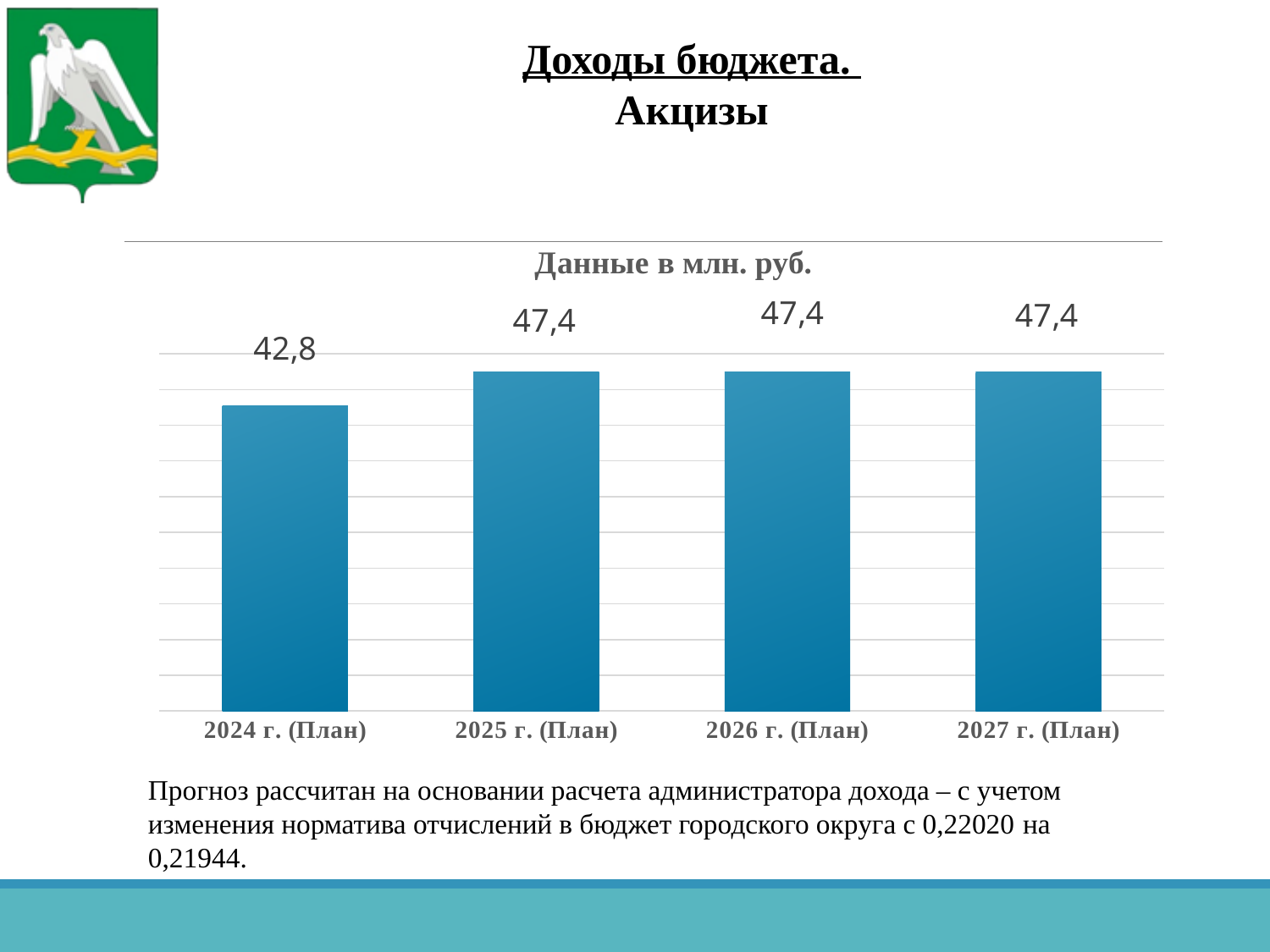
Do the values change from 2025 г. (План) to 2027 г. (План)? No, they stay at 47,4 What is the difference between the values for 2025 г. (План) and 2024 г. (План)? 4,6 Do the values rise or fall from 2024 г. (План) to 2025 г. (План)? Rise How many categories are shown on the chart? 4 What is the value for 2027 г. (План)? 47,4 Which category has the lowest value? 2024 г. (План) What colour are the bars in the chart? Blue What kind of chart is shown on the slide? Bar chart What is the value for 2025 г. (План)? 47,4 What is the value for 2024 г. (План)? 42,8 What is the title of the chart? Данные в млн. руб. Which is larger, the value for 2024 г. (План) or the value for 2026 г. (План)? 2026 г. (План)